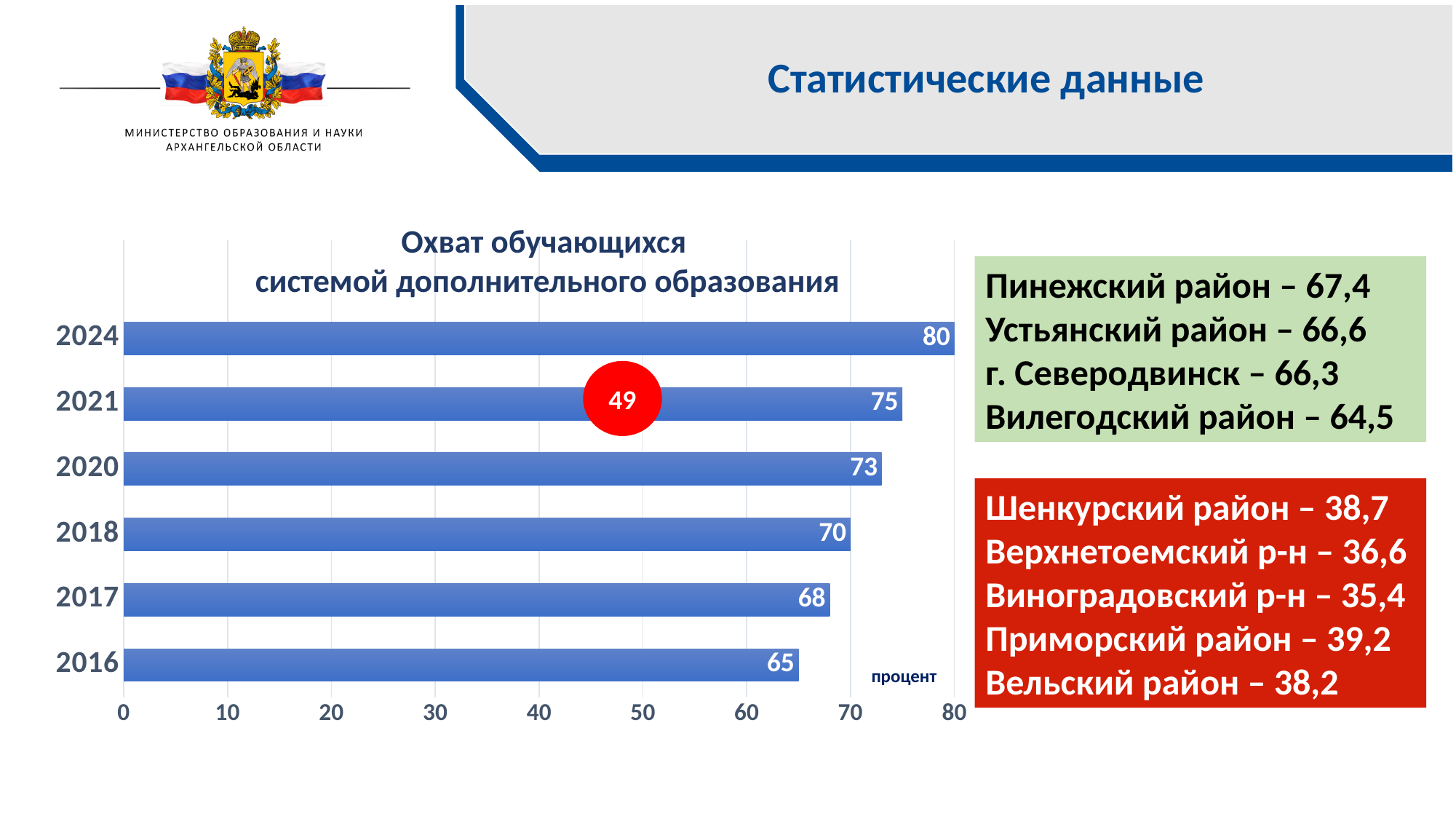
Is the value for 2018 greater or less than 60? greater Which year has the lowest value in the chart? 2016 How many years are shown in the chart? 6 What is the value for 2016 in the chart? 65 What is the value for 2024 in the chart "Охват обучающихся системой дополнительного образования"? 80 What kind of chart is shown on the slide? bar chart What is the value for 2020 in the chart? 73 What is the difference between the values for 2021 and 2018? 5 What unit label is shown next to the horizontal axis of the chart? процент What is the difference between the values for 2024 and 2016? 15 Which year has the highest value in the chart? 2024 Which is larger, the value for 2017 or the value for 2020? 2020